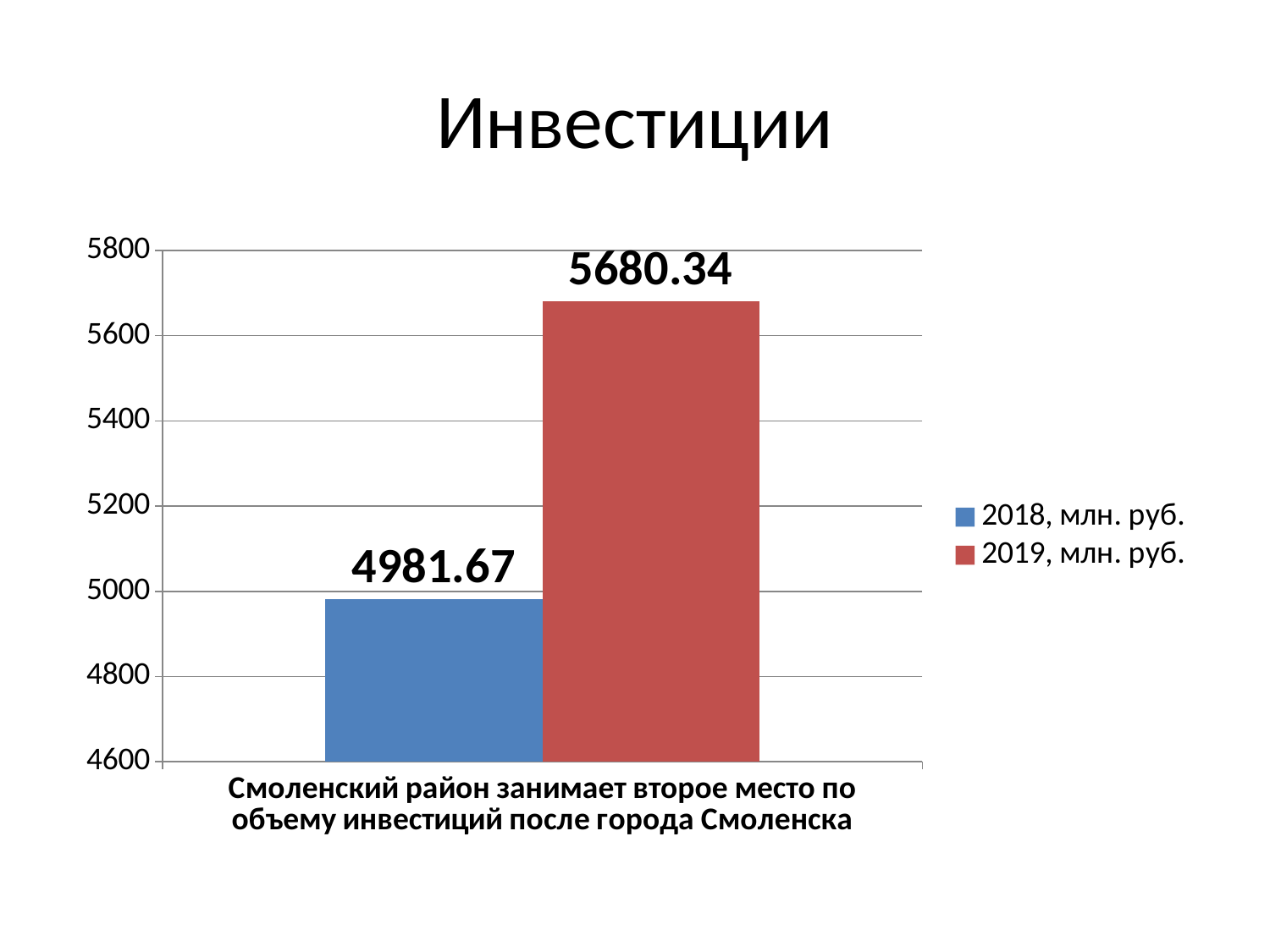
How many series does the legend list? 2 What is the title of the slide? Инвестиции What is the value for the 2018 series? 4981.67 Is the value for 2018 greater or less than 5000? less What kind of chart is shown on the slide? bar chart What is the value for the 2019 series? 5680.34 Which series has the higher value, 2018 or 2019? 2019 Is the value for 2019 greater or less than 5600? greater Do the values rise or fall from 2018 to 2019? rise Which series has the highest value? 2019, млн. руб. Which series has the lowest value? 2018, млн. руб. What is the difference between the 2019 value and the 2018 value? 698.67